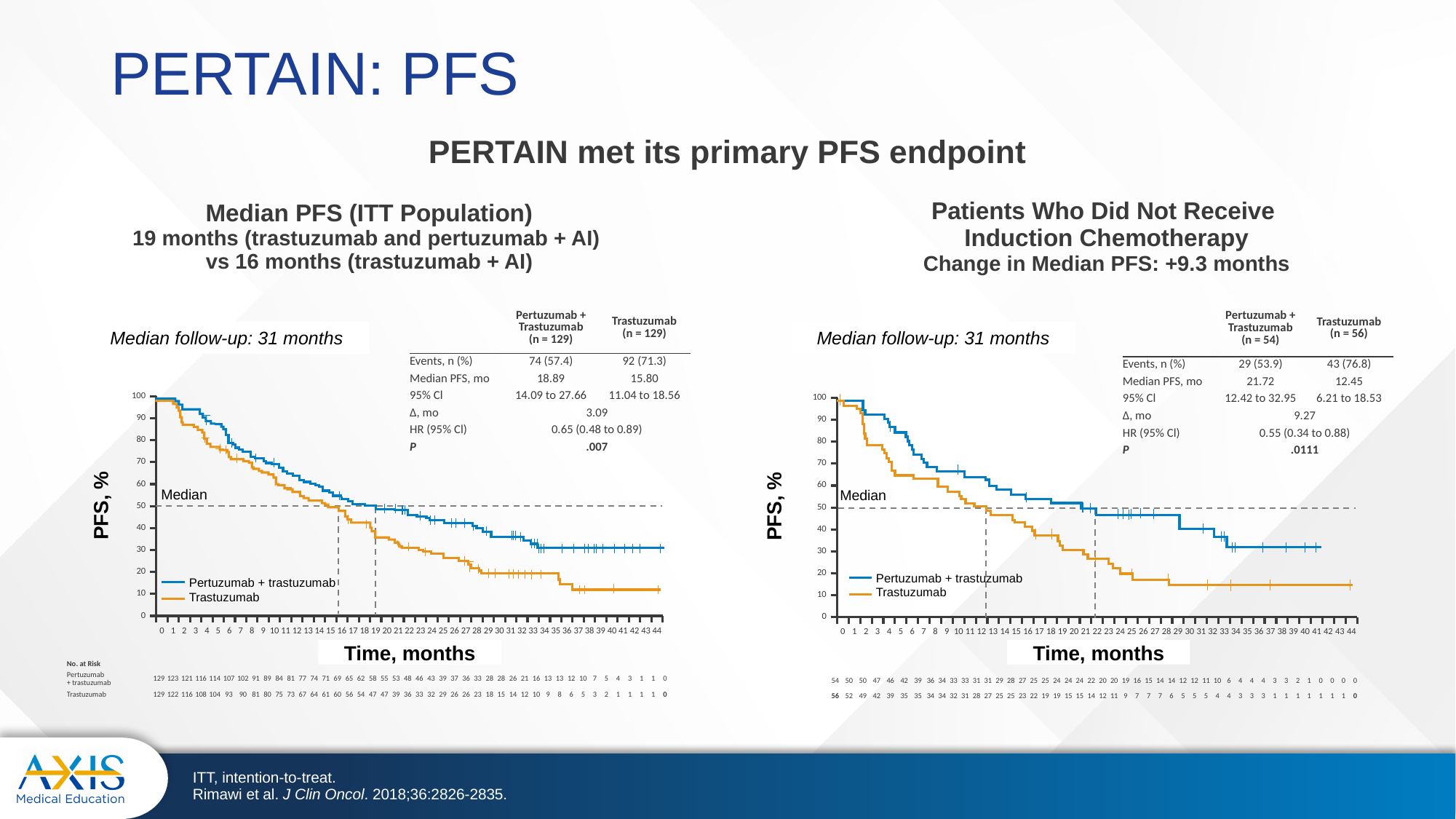
What kind of chart is the left chart (Median PFS, ITT Population)? Line chart (Kaplan-Meier curve) In the left chart (ITT Population), is the PFS value for the Trastuzumab curve at 44 months greater or less than 20? less In the left chart (ITT Population), do the PFS curves rise or fall as time in months increases? Fall In the right chart (Patients Who Did Not Receive Induction Chemotherapy), what is the median PFS in months for Trastuzumab? 12.45 How many series does the legend of the left chart (ITT Population) list? 2 What is the y-axis label on the left chart (ITT Population)? PFS, % In the right chart's table (Patients Who Did Not Receive Induction Chemotherapy), what is the HR (95% CI)? 0.55 (0.34 to 0.88) In the right chart (Patients Who Did Not Receive Induction Chemotherapy), is the PFS value for the Pertuzumab + trastuzumab curve at 40 months greater or less than 20? greater In the left chart's table (ITT Population), what is the median PFS in months for Trastuzumab? 15.80 In the right chart (Patients Who Did Not Receive Induction Chemotherapy), which arm has the higher median PFS? Pertuzumab + Trastuzumab In the left chart (ITT Population), what is the difference in median PFS (Δ, mo) between the two arms? 3.09 In the left chart's table (ITT Population), what is the median PFS in months for Pertuzumab + Trastuzumab? 18.89